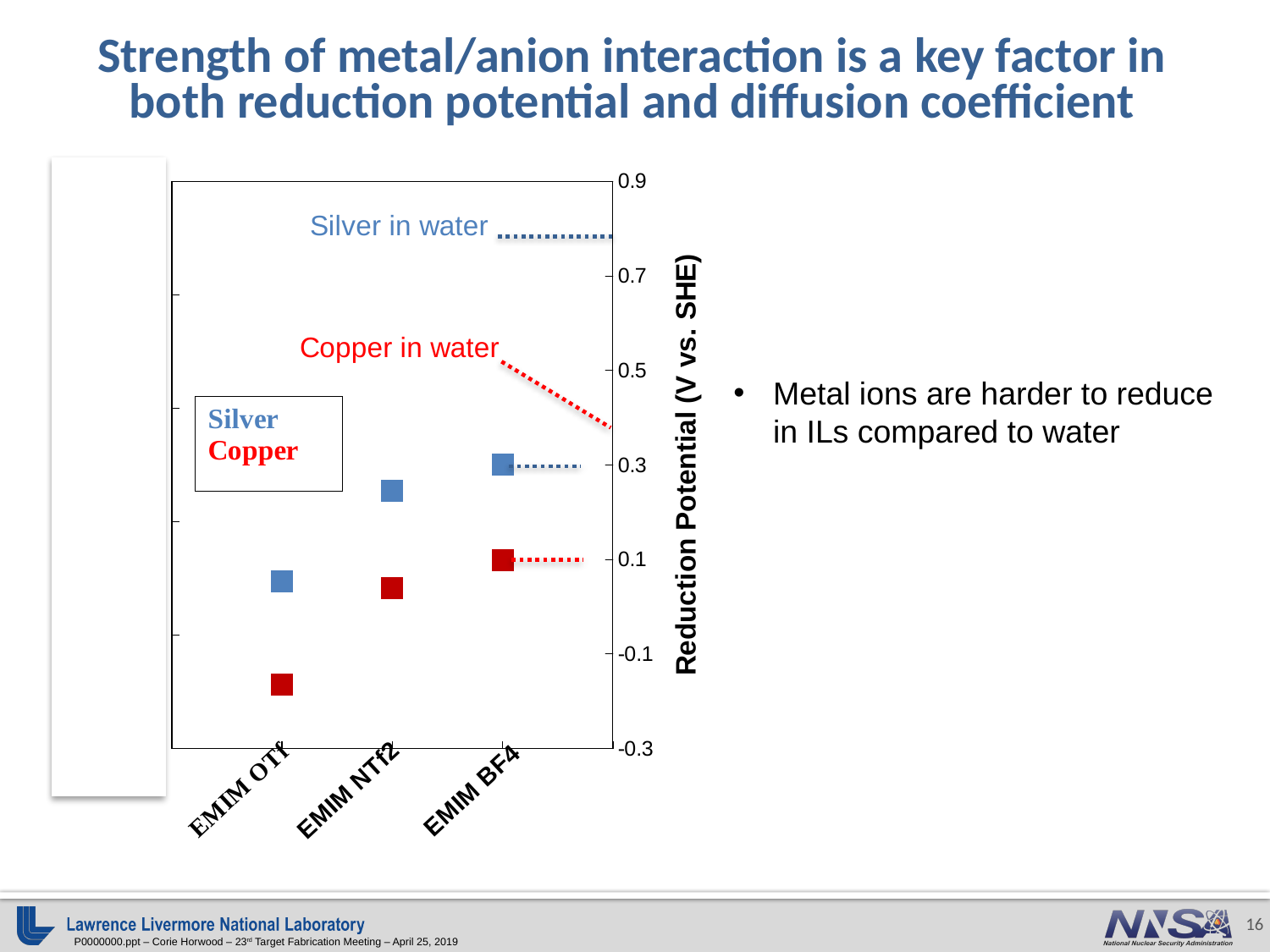
Is the reduction potential for Copper in EMIM NTf2 greater or less than 0.1? less How many ionic liquid categories are shown on the x axis of the chart? 3 What kind of chart is shown on the slide? scatter chart Which ionic liquid has the highest reduction potential for Copper? EMIM BF4 Is the reduction potential for Silver in EMIM NTf2 greater or less than 0.1? greater In EMIM OTf, which has the larger reduction potential, Silver or Copper? Silver Does the reduction potential for Silver rise or fall moving from EMIM OTf to EMIM BF4 along the x axis? rise How many series does the chart's legend list? 2 What is the title of the chart's vertical axis? Reduction Potential (V vs. SHE) Which ionic liquid has the lowest reduction potential for Copper? EMIM OTf Which ionic liquid has the lowest reduction potential for Silver? EMIM OTf Is the reduction potential for Copper in EMIM OTf greater or less than -0.1? less